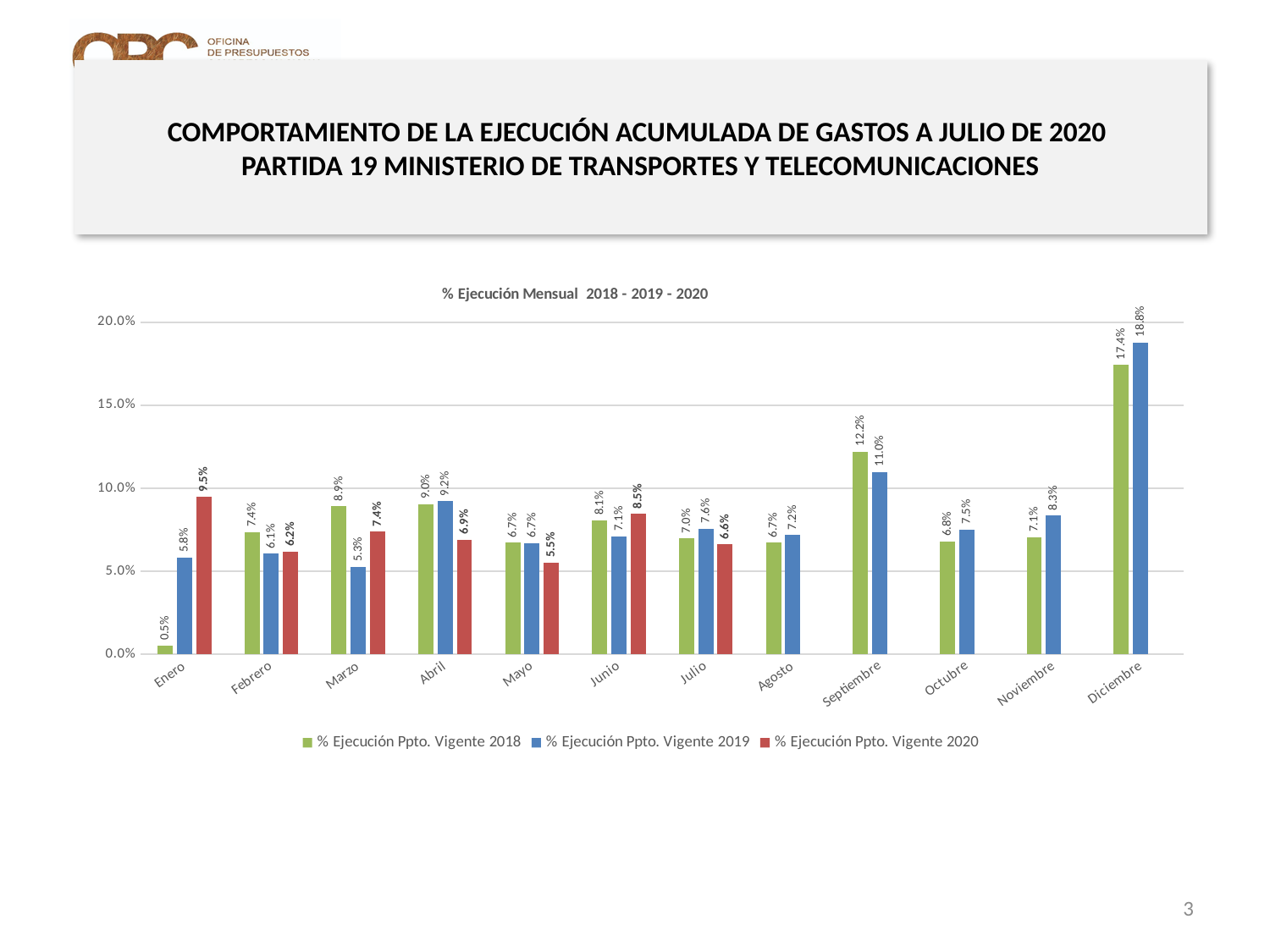
What is the value for % Ejecución Ppto. Vigente 2020 in Enero? 9.5% Which month has the highest value for % Ejecución Ppto. Vigente 2019? Diciembre Is the value for % Ejecución Ppto. Vigente 2018 in Septiembre greater or less than 10.0%? greater How many months are shown on the x axis? 12 What is the title of the chart? % Ejecución Mensual 2018 - 2019 - 2020 Which month has the lowest value for % Ejecución Ppto. Vigente 2018? Enero How many series does the legend list? 3 In Marzo, which is larger: the 2018 value or the 2019 value? 2018 What is the value for % Ejecución Ppto. Vigente 2019 in Septiembre? 11.0% What is the difference between the 2019 and 2018 values in Diciembre? 1.4% What is the value for % Ejecución Ppto. Vigente 2018 in Diciembre? 17.4% What kind of chart is shown on the slide? Bar chart